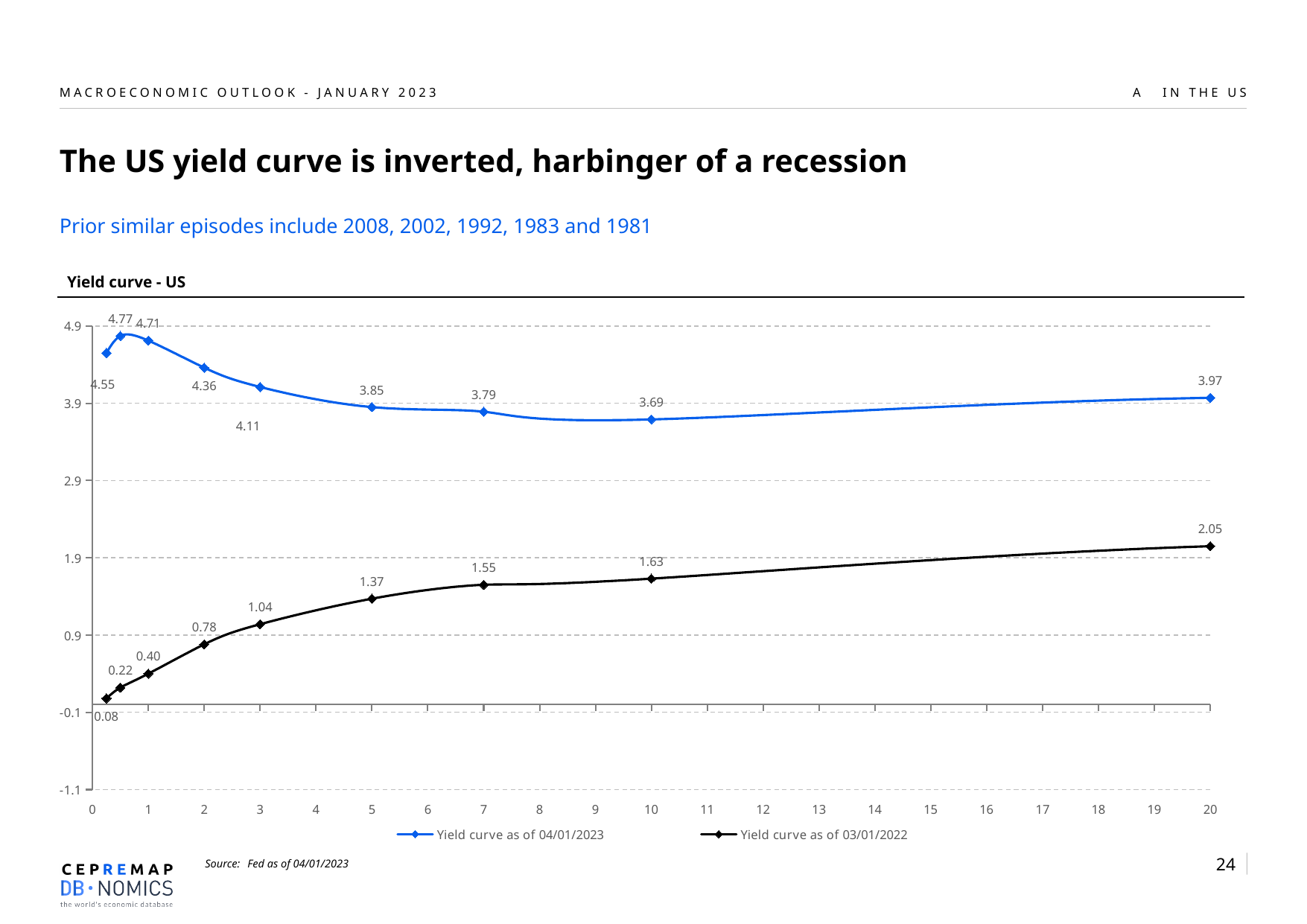
At maturity 5, which series has the higher value? Yield curve as of 04/01/2023 What is the highest labelled value on the 'Yield curve as of 04/01/2023' series? 4.77 What is the value of the 'Yield curve as of 03/01/2022' series at maturity 10? 1.63 What is the value of the 'Yield curve as of 04/01/2023' series at maturity 20? 3.97 Does the 'Yield curve as of 03/01/2022' series rise or fall as maturity increases from 0 to 20? rises How many series does the legend list? 2 What is the value of the 'Yield curve as of 04/01/2023' series at maturity 10? 3.69 What kind of chart is shown on the slide? line chart What is the lowest labelled value on the 'Yield curve as of 04/01/2023' series? 3.69 At maturity 20, what is the difference between the 04/01/2023 value and the 03/01/2022 value? 1.92 On the 'Yield curve as of 03/01/2022' series, how much higher is the value at maturity 7 than at maturity 5? 0.18 Is the value of the 'Yield curve as of 04/01/2023' series at maturity 3 greater or less than 3.9? greater